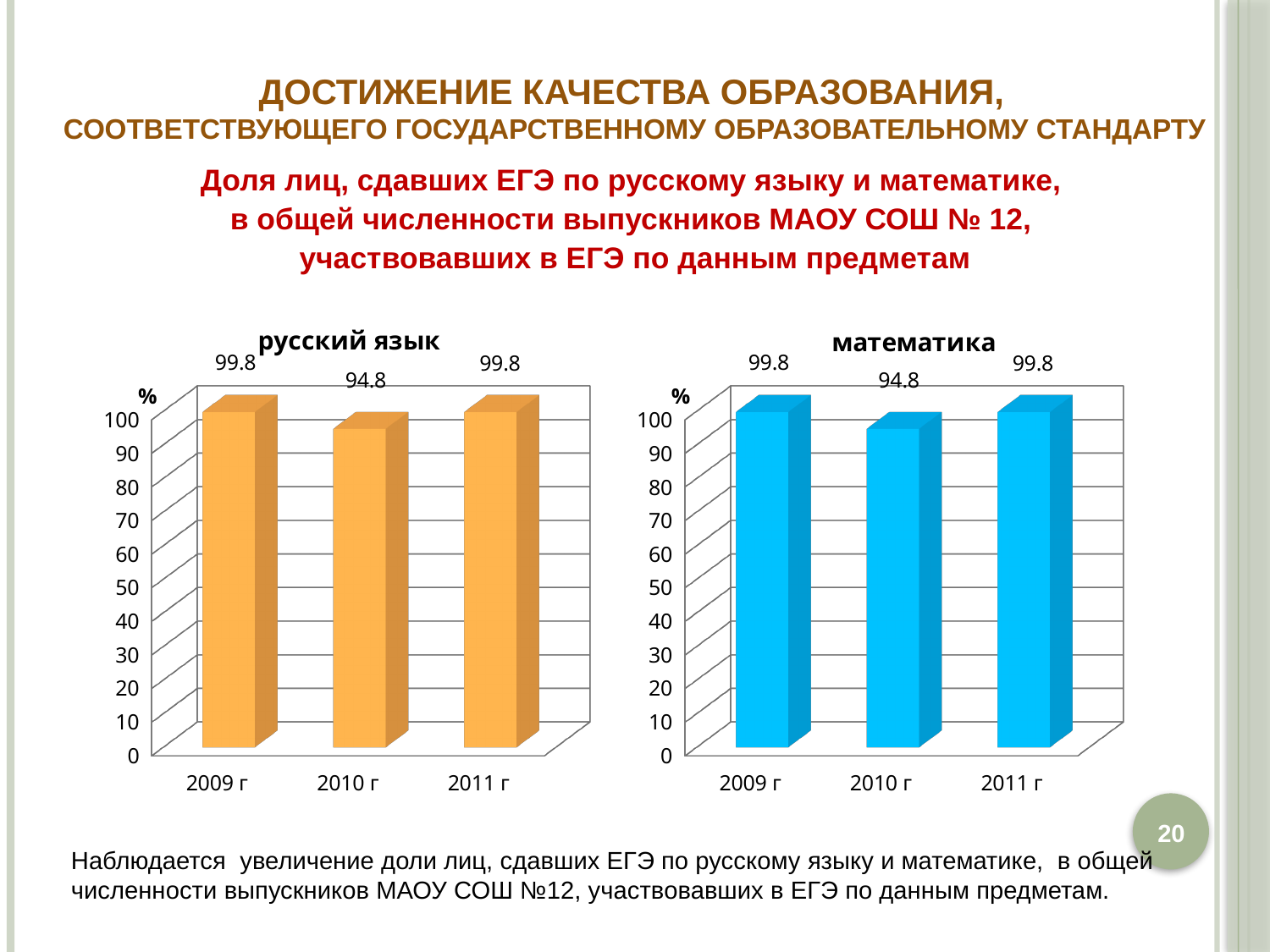
What kind of chart is the 'математика' chart? bar chart How many years are shown in the 'русский язык' chart? 3 What is the title of the left chart? русский язык In the 'математика' chart, what is the value for 2011 г? 99.8 In the 'математика' chart, which year has the lowest value? 2010 г In the 'математика' chart, what colour are the bars? blue In the 'русский язык' chart, what is the difference between the values for 2009 г and 2010 г? 5 In the 'русский язык' chart, is the value for 2010 г greater or less than 90? greater In the 'математика' chart, what is the difference between the values for 2011 г and 2010 г? 5 In the 'русский язык' chart, what is the value for 2010 г? 94.8 In the 'математика' chart, which is larger, the value for 2009 г or the value for 2010 г? 2009 г In the 'русский язык' chart, which year has the lowest value? 2010 г